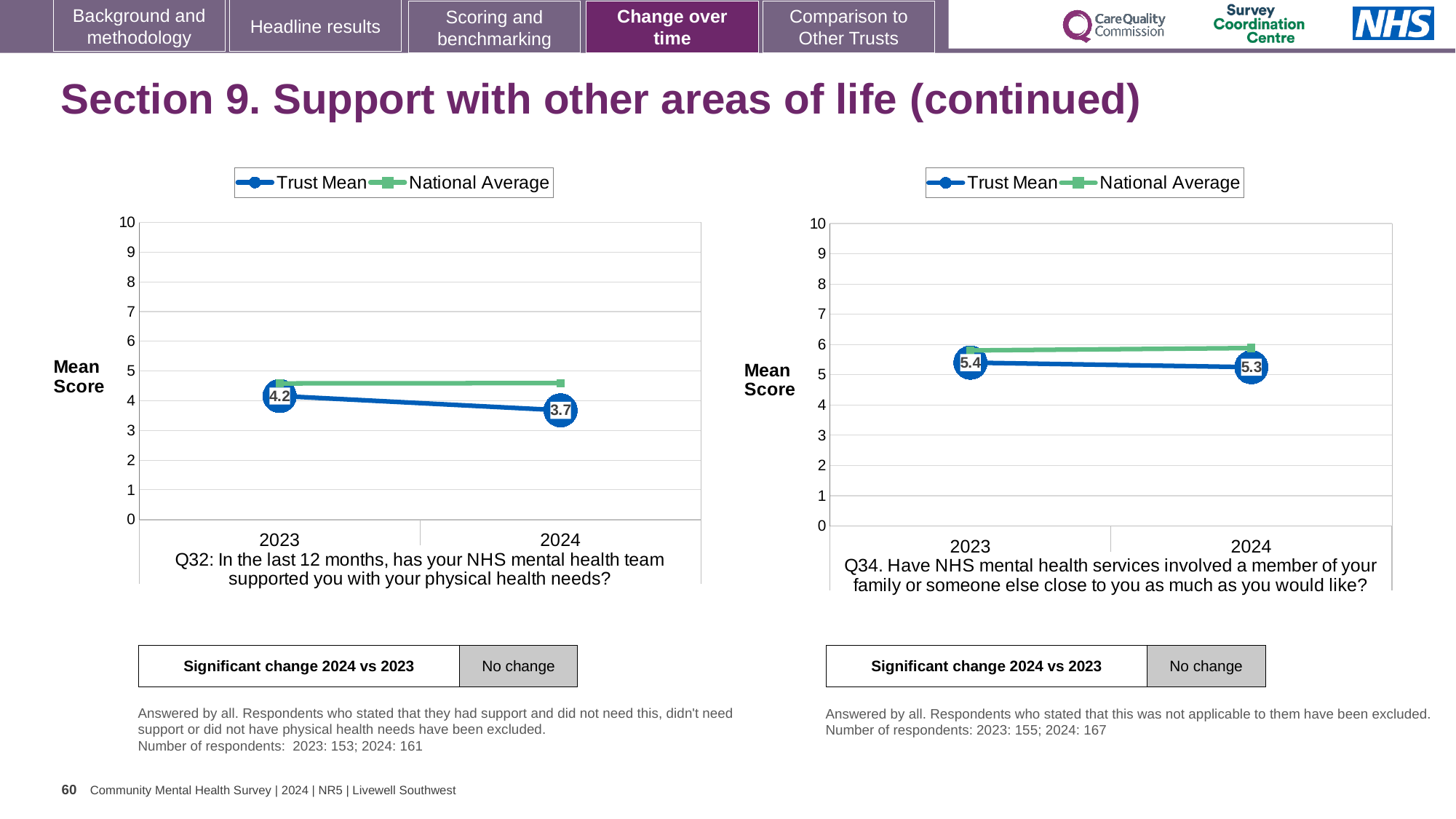
In the Q32 chart on the left, what is the Trust Mean score for 2024? 3.7 How many series does the legend of the Q32 chart on the left list? 2 In the Q32 chart on the left, does the Trust Mean rise or fall from 2023 to 2024? fall In the Q32 chart on the left, by how much did the Trust Mean fall from 2023 to 2024? 0.5 In the Q34 chart on the right, what is the Trust Mean score for 2023? 5.4 In the Q34 chart on the right, what is the Trust Mean score for 2024? 5.3 What kind of chart is the Q32 chart on the left? line chart In the Q34 chart on the right, what is the difference between the Trust Mean in 2023 and 2024? 0.1 In the Q32 chart on the left, what is the Trust Mean score for 2023? 4.2 How many years are plotted on the x axis of the Q34 chart on the right? 2 In the Q34 chart on the right, is the National Average value for 2024 greater or less than 5? greater In the Q32 chart on the left, which is higher in 2024, the Trust Mean or the National Average? National Average